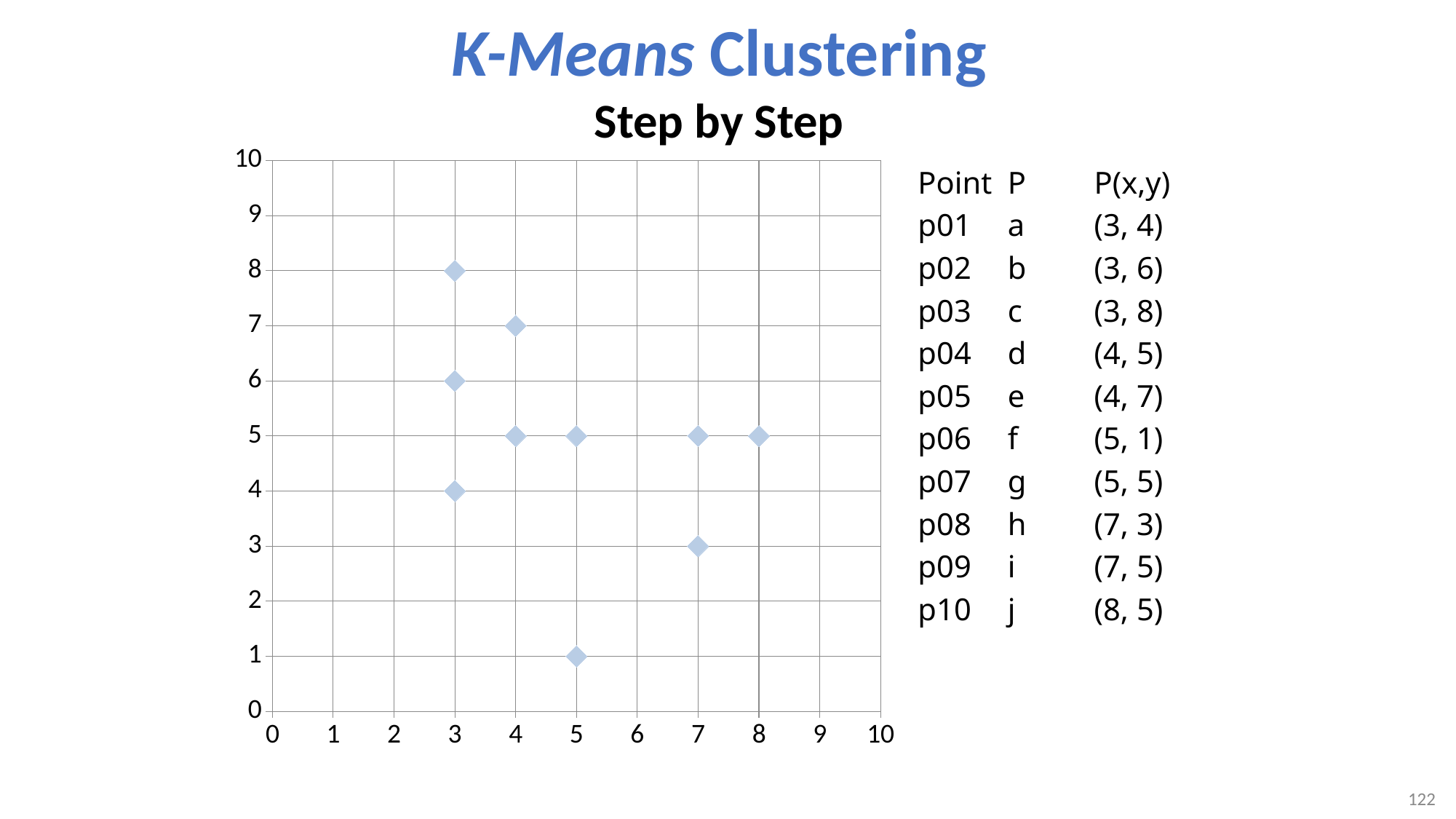
What is the lowest y value among the plotted points? 1 What is the y coordinate of the point plotted at x = 8? 5 How many points are plotted at x = 3? 3 What is the difference in y between the highest point and the lowest point? 7 How many data points are plotted on the chart? 10 What is the highest y value among the plotted points? 8 How many points are plotted at y = 5? 4 What kind of chart is shown on the slide? scatter chart What is the largest x value among the plotted points? 8 What is the maximum value shown on the x axis? 10 What is the y coordinate of the point plotted at x = 7 that is not at y = 5? 3 Is the y value of the point at x = 5 with the lowest y greater or less than 2? less